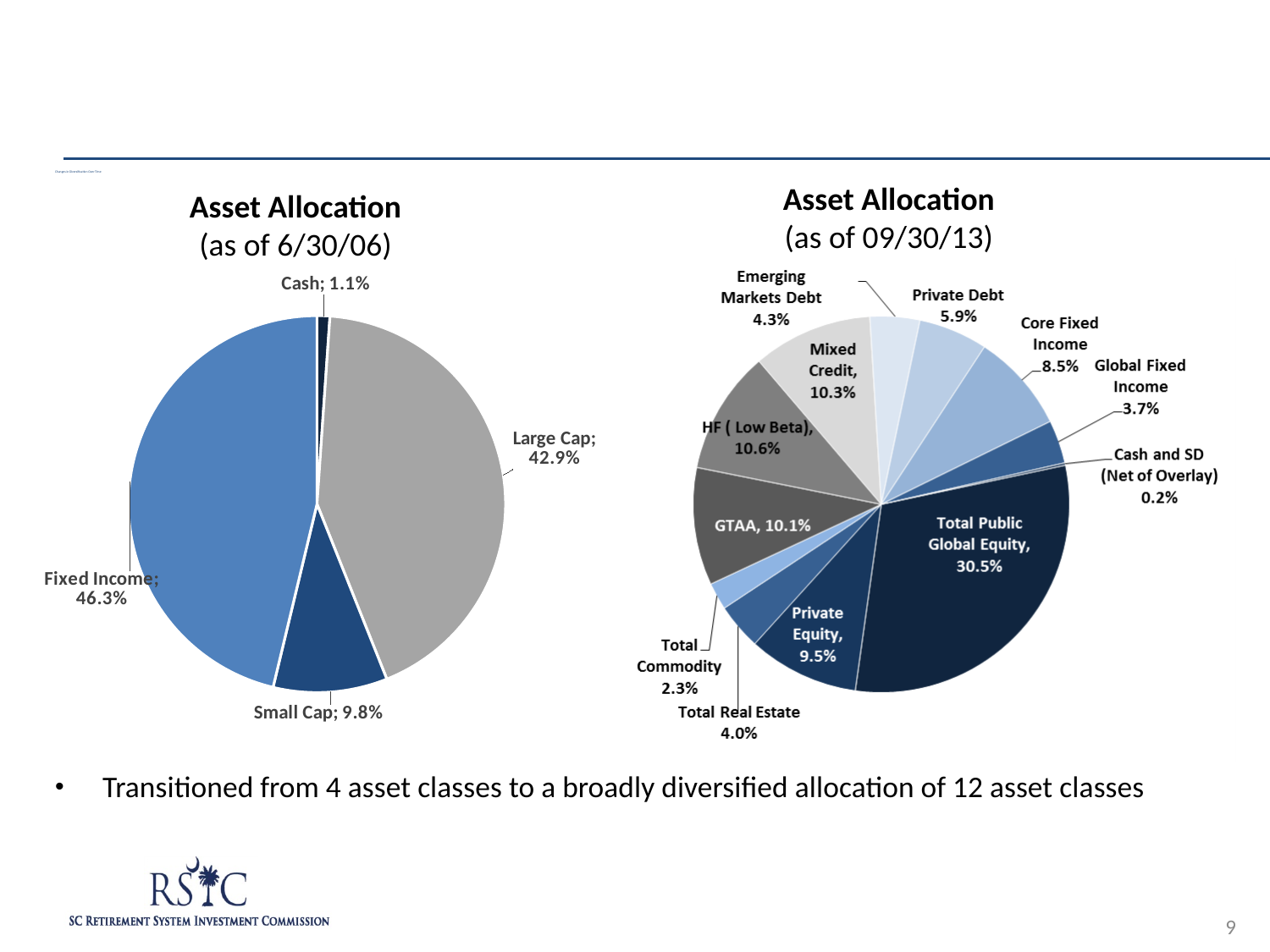
In the Asset Allocation (as of 6/30/06) chart, which asset class has the smallest share? Cash How many asset classes are shown in the Asset Allocation (as of 6/30/06) chart? 4 In the Asset Allocation (as of 09/30/13) chart, which asset class has the smallest share? Cash and SD (Net of Overlay) In the Asset Allocation (as of 6/30/06) chart, what share is Fixed Income? 46.3% In the Asset Allocation (as of 6/30/06) chart, what is the difference between the Fixed Income and Large Cap shares? 3.4% In the Asset Allocation (as of 09/30/13) chart, what share is Mixed Credit? 10.3% In the Asset Allocation (as of 09/30/13) chart, which asset class has the largest share? Total Public Global Equity What type of chart is used for the Asset Allocation (as of 09/30/13)? Pie chart How many asset classes are shown in the Asset Allocation (as of 09/30/13) chart? 12 In the Asset Allocation (as of 09/30/13) chart, which is larger: Private Equity or Private Debt? Private Equity In the Asset Allocation (as of 09/30/13) chart, what share is Total Public Global Equity? 30.5% In the Asset Allocation (as of 6/30/06) chart, what share is Small Cap? 9.8%